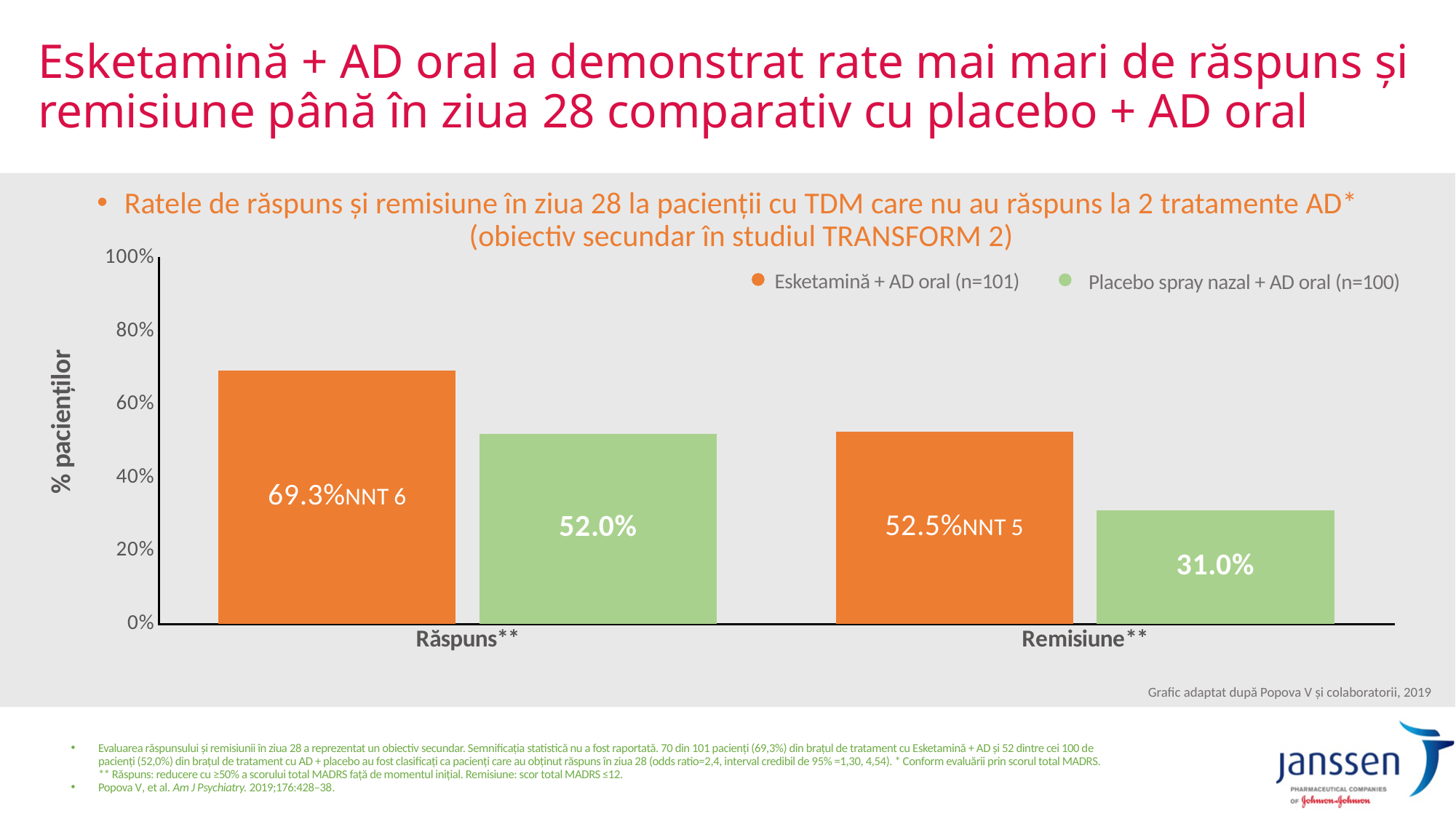
Which bar has the lowest value on the chart? Placebo spray nazal + AD oral, Remisiune What is the value for Esketamină + AD oral in the Remisiune category? 52.5% How many series does the legend list? 2 How many categories are shown on the x axis? 2 What is the difference between Esketamină + AD oral and Placebo spray nazal + AD oral in the Răspuns category? 17.3% Which is larger: Placebo spray nazal + AD oral for Răspuns or Esketamină + AD oral for Remisiune? Esketamină + AD oral for Remisiune What kind of chart is shown on the slide? Bar chart What is the difference between Esketamină + AD oral and Placebo spray nazal + AD oral in the Remisiune category? 21.5% What is the value for Esketamină + AD oral in the Răspuns category? 69.3% Which bar has the highest value on the chart? Esketamină + AD oral, Răspuns What is the value for Placebo spray nazal + AD oral in the Remisiune category? 31.0% What is the value for Placebo spray nazal + AD oral in the Răspuns category? 52.0%